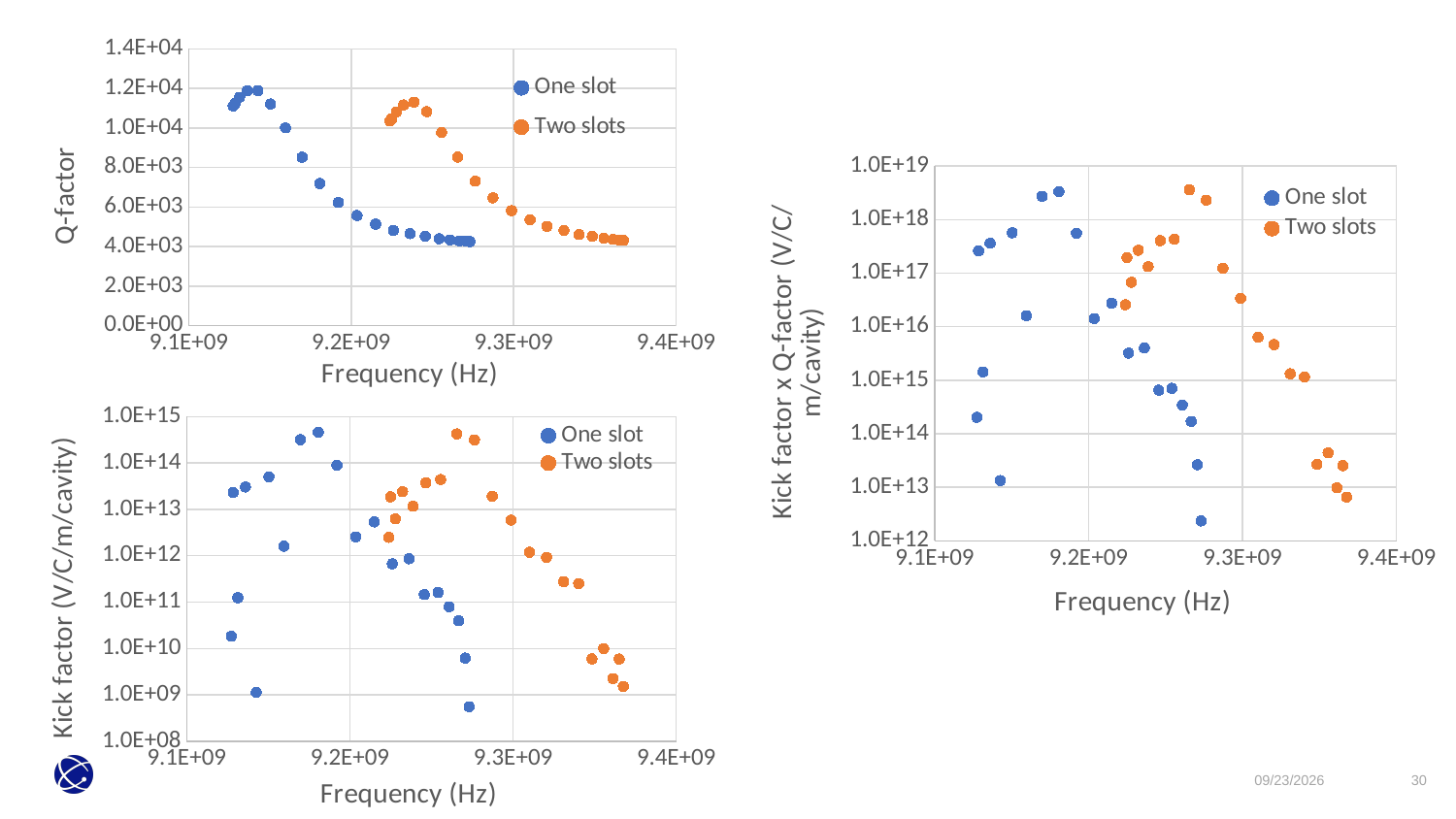
In the Q-factor chart, do the Two slots values rise or fall as frequency increases beyond 9.25E+09 Hz? fall In the Kick factor x Q-factor chart, is the highest Two slots value greater or less than 1.0E+18? greater How many series does the legend list in the Q-factor chart? 2 In the Kick factor x Q-factor chart, are the Two slots values near 9.36E+09 Hz greater or less than 1.0E+14? less What is the x-axis label of the bottom-left Kick factor chart? Frequency (Hz) In the Kick factor chart, which series contains the lowest plotted point? One slot In the Kick factor chart, is the highest One slot value greater or less than 1.0E+14? greater In the Q-factor chart, which series reaches the higher peak Q-factor, One slot or Two slots? One slot What kind of chart is the top-left chart with Q-factor on the y axis? scatter chart What are the two legend entries in the Kick factor x Q-factor chart on the right? One slot, Two slots